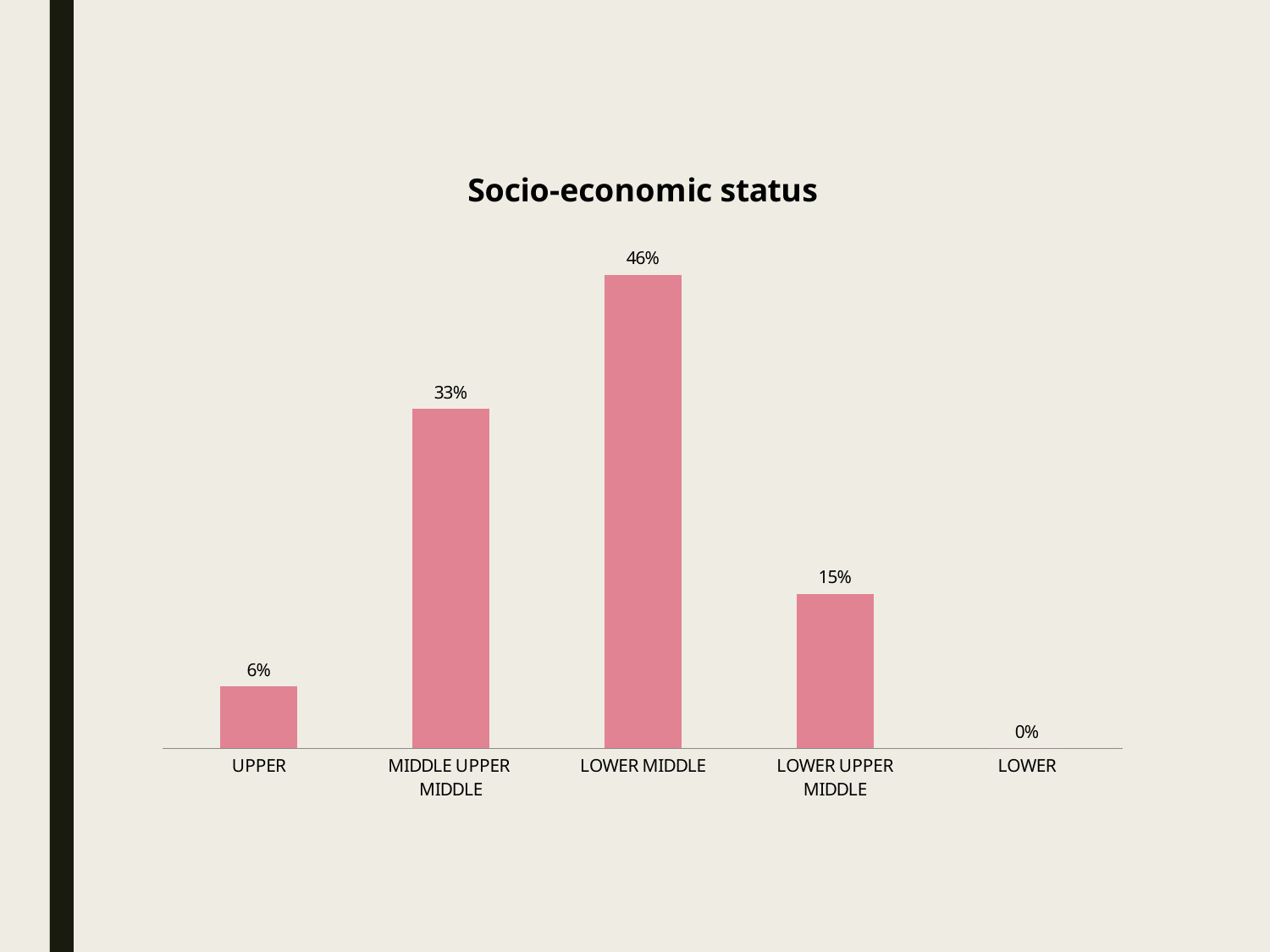
What is the value for UPPER? 6% Which category has the highest value? LOWER MIDDLE What is the difference between the values for LOWER MIDDLE and MIDDLE UPPER MIDDLE? 13% What kind of chart is shown on the slide? Bar chart How many categories are shown on the x axis? 5 Which is larger, the value for MIDDLE UPPER MIDDLE or the value for LOWER UPPER MIDDLE? MIDDLE UPPER MIDDLE Which category has the lowest value? LOWER What is the value for LOWER MIDDLE? 46% What is the value for LOWER? 0% What is the value for LOWER UPPER MIDDLE? 15% What is the title of the chart? Socio-economic status What is the difference between the values for LOWER UPPER MIDDLE and UPPER? 9%